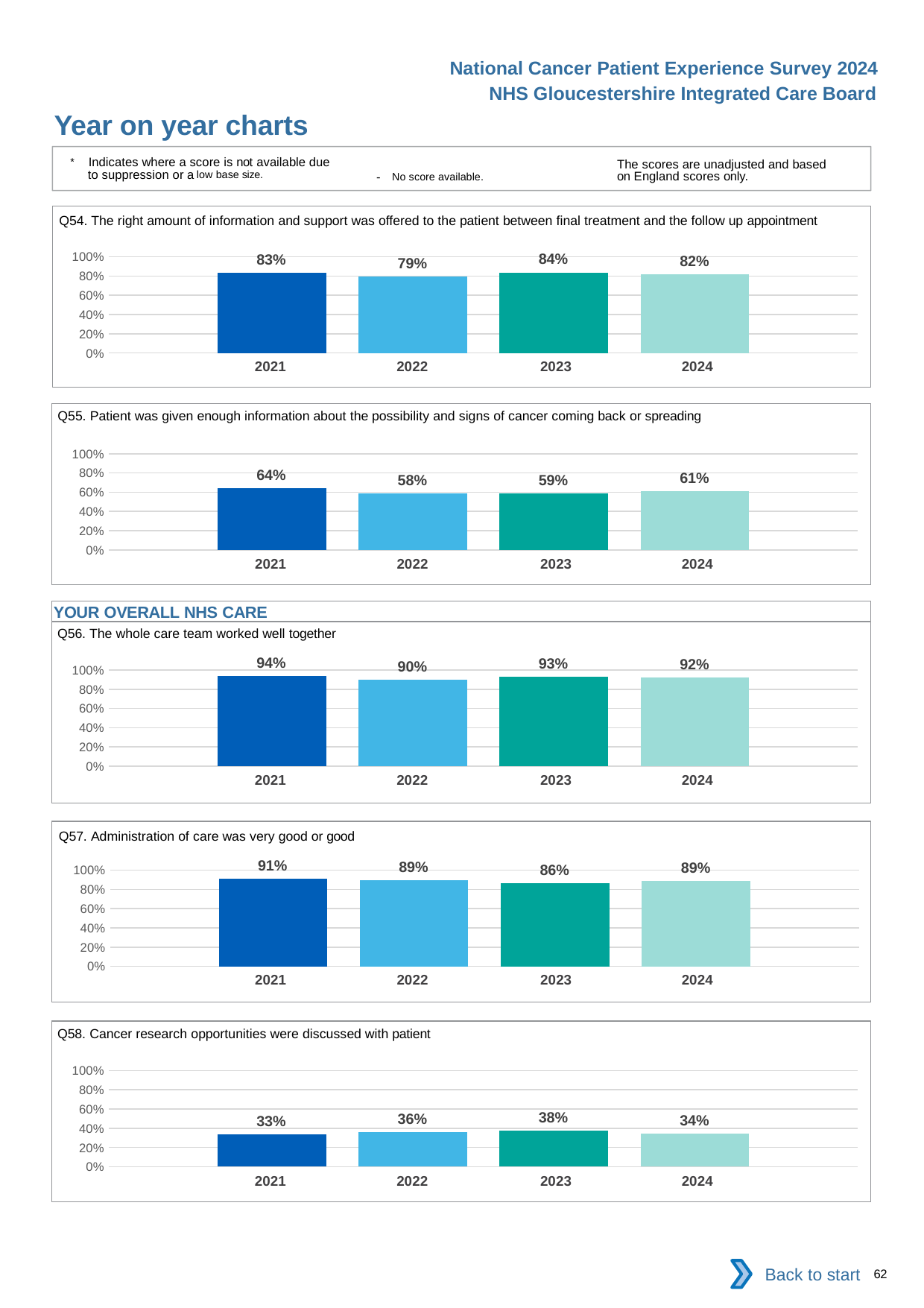
In the Q55 chart, what is the value for 2024? 61% In the Q57 chart, what is the difference between the 2024 and 2023 values? 3% In the Q58 chart, is the value for 2021 greater or less than 40%? less In the Q54 chart, what is the value for 2023? 84% In the Q58 chart, which year has the highest value? 2023 In the Q56 chart, what is the difference between the 2021 and 2022 values? 4% In the Q54 chart, which year has the lowest value? 2022 What kind of chart is the Q56 chart? bar chart Which section heading appears above the Q56 chart? YOUR OVERALL NHS CARE In the Q55 chart, which year has the lowest value? 2022 In the Q57 chart, which is larger, the value for 2021 or the value for 2023? 2021 How many years are shown in the Q55 chart? 4